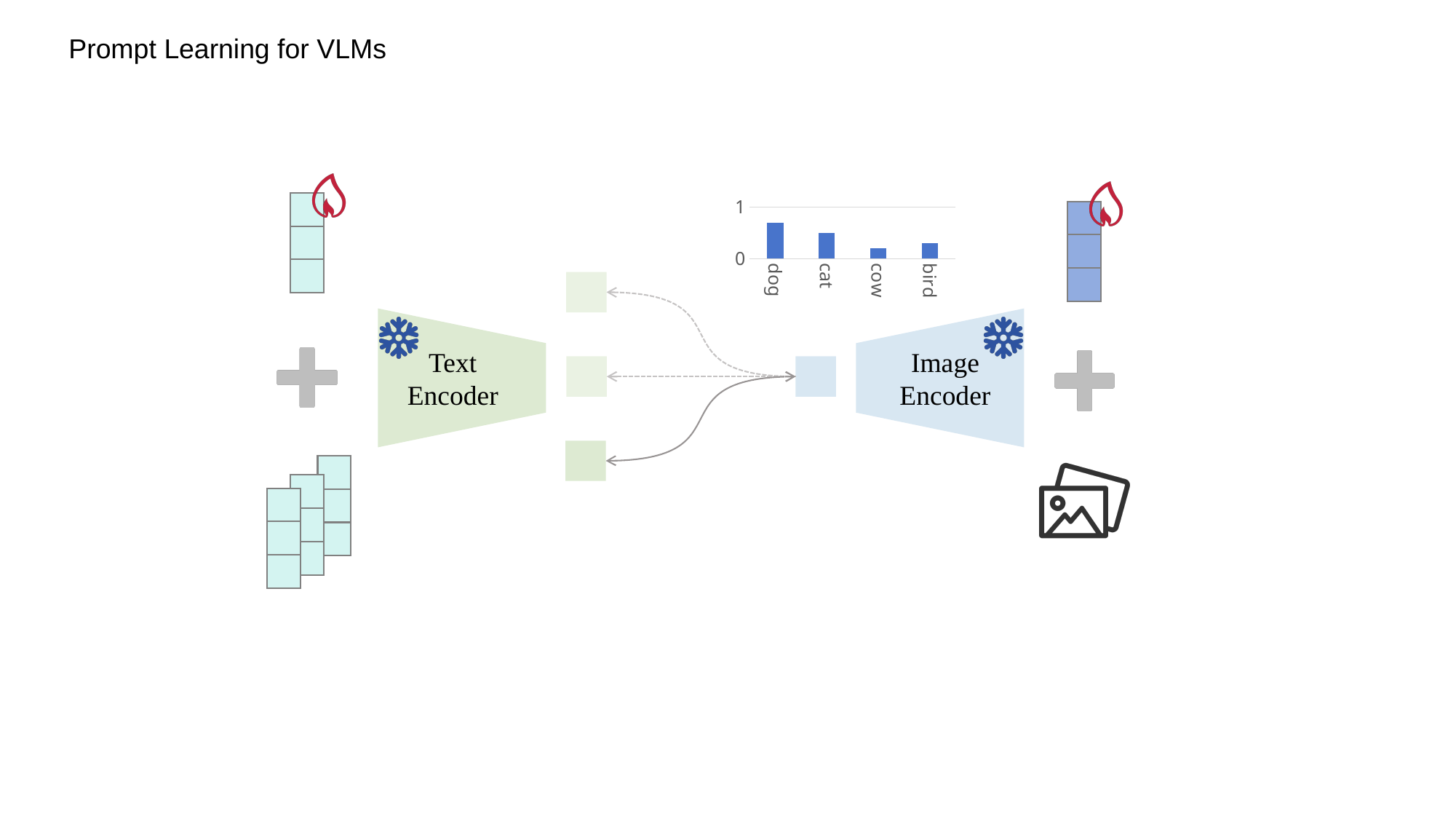
Is the value for cow greater or less than 1? less Which is larger in the chart, the value for cat or the value for bird? cat What are the category labels on the x axis of the bar chart, from left to right? dog, cat, cow, bird Which category has the highest bar in the chart? dog Is the value for dog greater or less than 1? less What is the highest tick value shown on the y axis of the bar chart? 1 Which is larger in the chart, the value for dog or the value for cat? dog What kind of chart is shown on the slide? bar chart Which category has the lowest bar in the chart? cow How many categories does the bar chart show? 4 Which is larger in the chart, the value for bird or the value for cow? bird